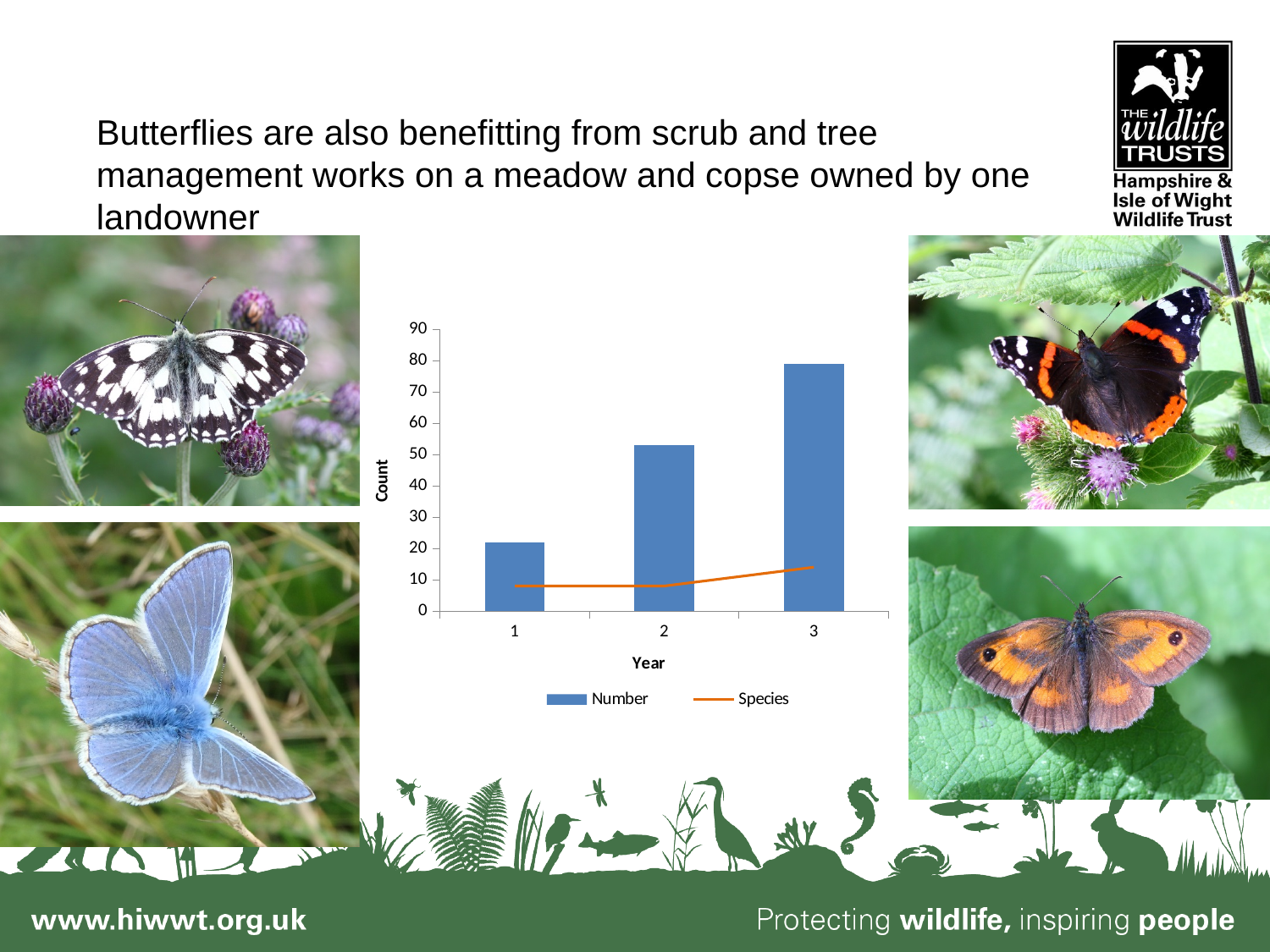
Is the Number value for year 1 greater or less than 30? less Is the Number value for year 3 greater or less than 70? greater Which year has the lowest Number bar? 1 Which year has the highest Number bar? 3 What are the two series named in the chart legend? Number and Species What kind of chart is shown on the slide? combination bar and line chart How many series does the chart legend list? 2 Do the Number bars rise or fall from year 1 to year 3? rise Is the Number value for year 2 greater or less than 60? less How many years are shown on the x axis of the chart? 3 Is the Number bar for year 2 larger or smaller than the Number bar for year 1? larger